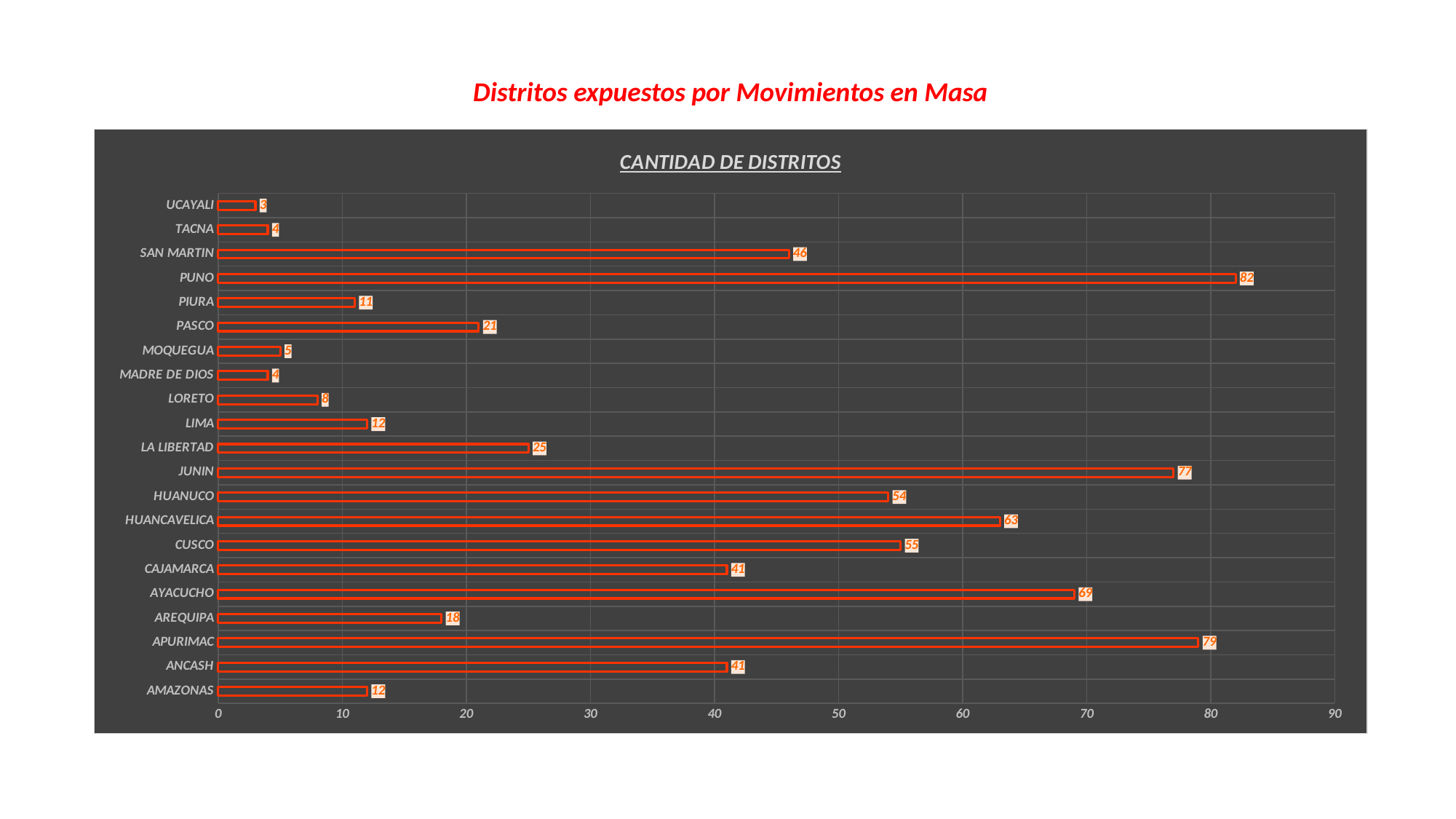
Is the value for PASCO greater or less than 20? greater What is the value for HUANCAVELICA? 63 What is the title of the chart? CANTIDAD DE DISTRITOS What is the value for PUNO? 82 How many categories are shown in the chart? 21 What is the difference between the values for PUNO and JUNIN? 5 Which category has the highest value? PUNO What is the value for LA LIBERTAD? 25 What is the difference between the values for APURIMAC and AYACUCHO? 10 Which is larger, the value for SAN MARTIN or the value for CAJAMARCA? SAN MARTIN What kind of chart is shown on the slide? bar chart Which category has the lowest value? UCAYALI